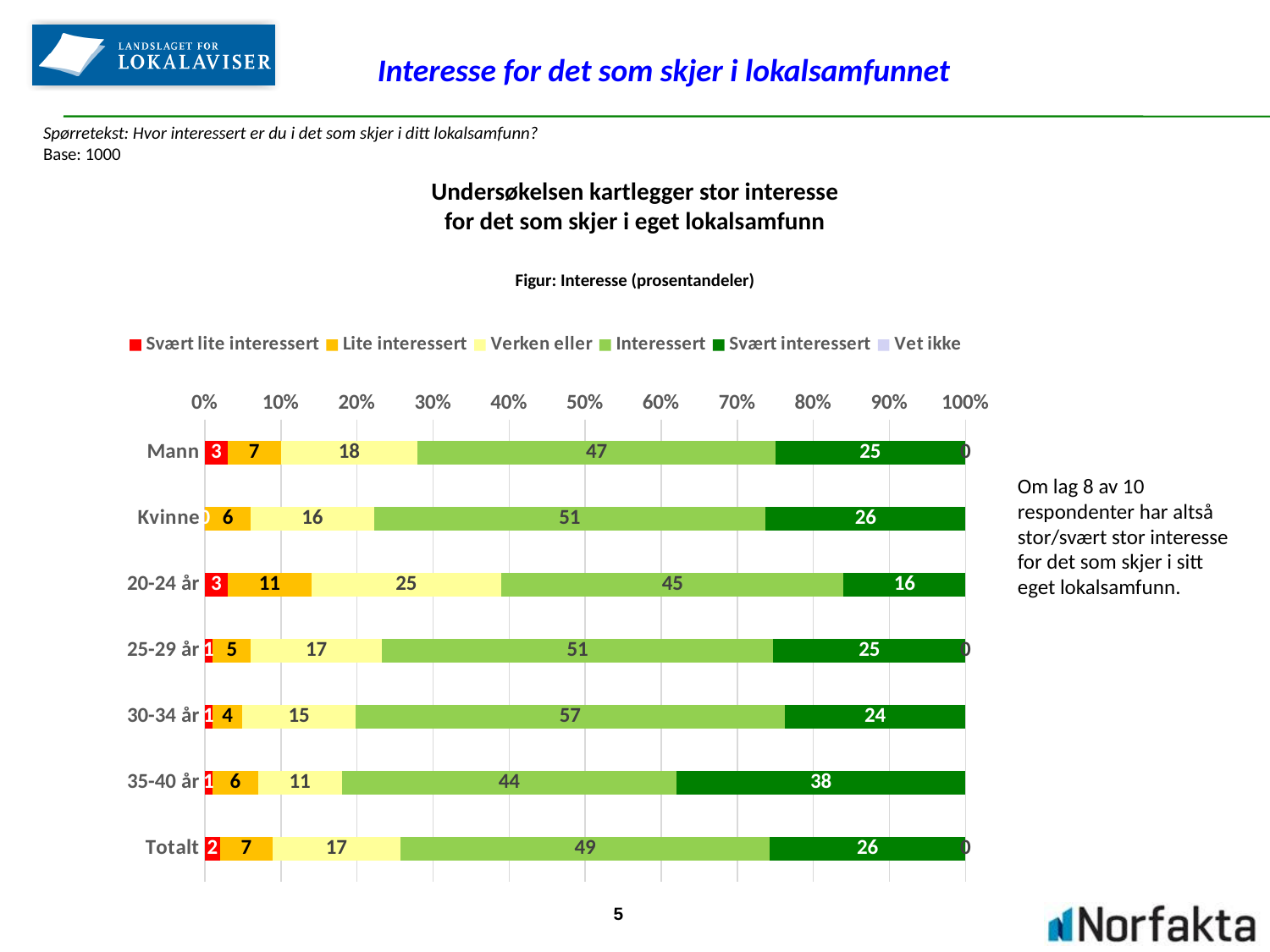
Which series is shown in red in the legend? Svært lite interessert What kind of chart is shown on the slide? Stacked bar chart What is the value for 'Svært interessert' in the 35-40 år category? 38 What is the difference between the 'Interessert' values for Kvinne and Mann? 4 Which category has the lowest value for 'Svært interessert'? 20-24 år What is the value for 'Lite interessert' in the Totalt category? 7 What is the value for 'Verken eller' in the 20-24 år category? 25 What is the value for 'Interessert' in the 30-34 år category? 57 How many series does the legend list? 6 Which is larger: the 'Verken eller' value for Mann or for Kvinne? Mann How many categories are shown on the vertical axis of the chart? 7 Which category has the highest value for 'Svært interessert'? 35-40 år